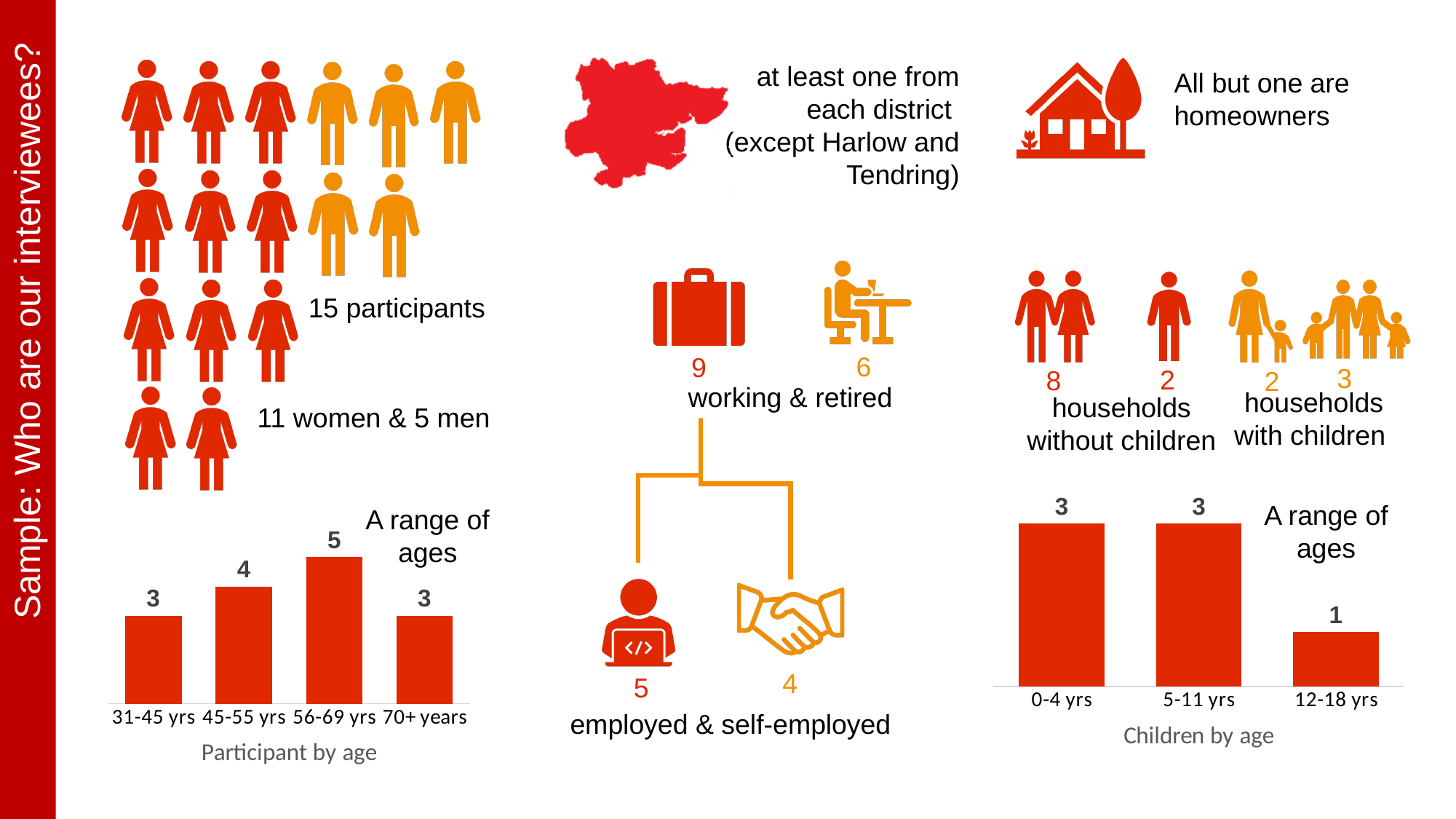
In the 'Participant by age' chart, what is the value for 45-55 yrs? 4 In the 'Participant by age' chart, what is the difference between the values for 56-69 yrs and 31-45 yrs? 2 What kind of chart is 'Participant by age'? Bar chart In the 'Participant by age' chart, which is larger: the value for 45-55 yrs or the value for 70+ years? 45-55 yrs In the 'Participant by age' chart, which age group has the highest value? 56-69 yrs In the 'Participant by age' chart, what is the value for 56-69 yrs? 5 How many age categories are shown in the 'Children by age' chart? 3 In the 'Children by age' chart, which age group has the lowest value? 12-18 yrs What is the title of the bar chart on the right side of the slide? Children by age In the 'Children by age' chart, what is the difference between the values for 0-4 yrs and 12-18 yrs? 2 How many age categories are shown in the 'Participant by age' chart? 4 In the 'Children by age' chart, what is the value for 12-18 yrs? 1